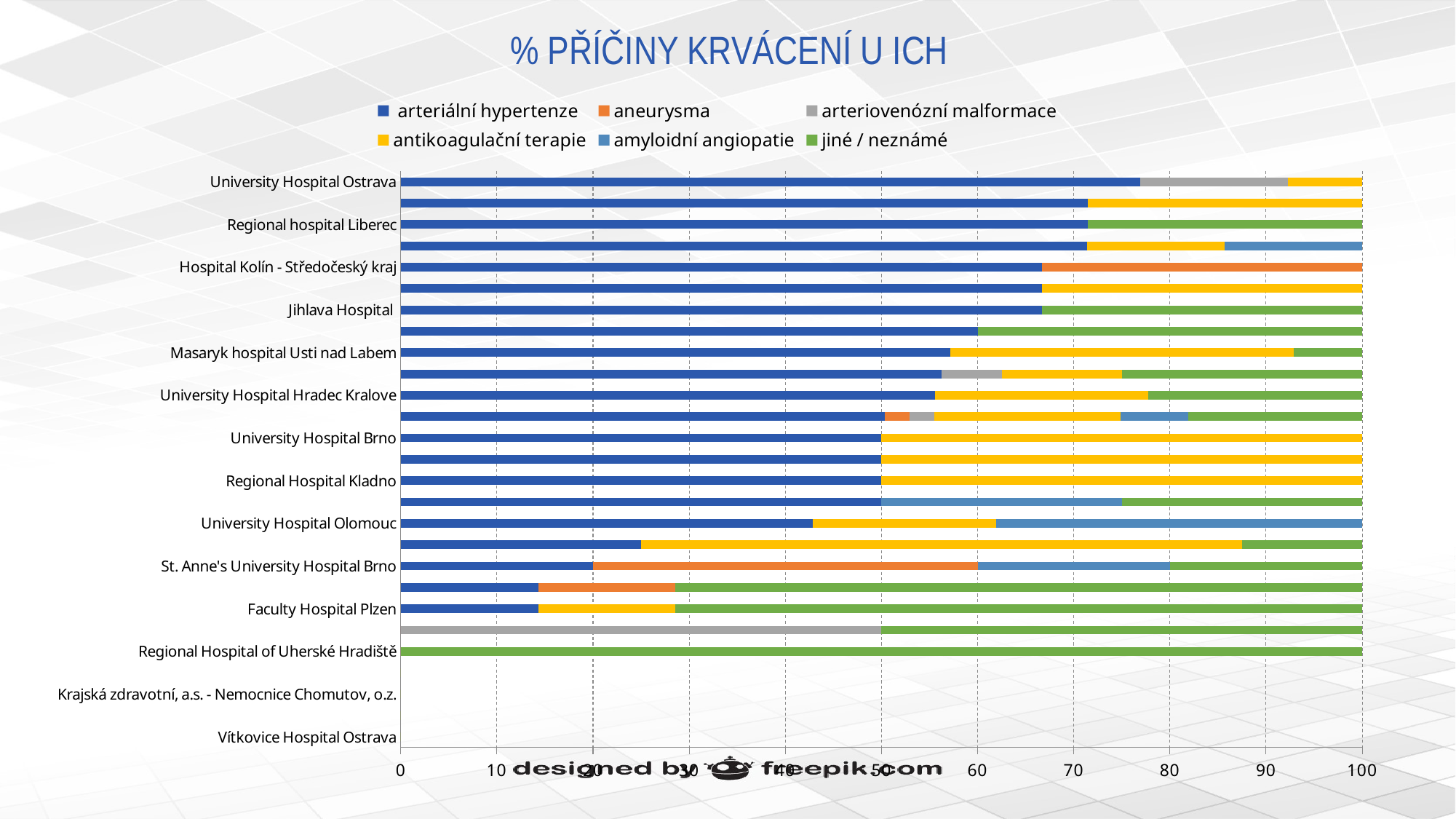
Is the value of 'arteriální hypertenze' for St. Anne's University Hospital Brno greater or less than 30? less Which colour represents 'aneurysma' in the legend? orange Is the value of 'arteriální hypertenze' for Hospital Kolín - Středočeský kraj greater or less than 70? less Is the value of 'arteriální hypertenze' for Faculty Hospital Plzen greater or less than 20? less Which has a larger value of 'amyloidní angiopatie': University Hospital Olomouc or St. Anne's University Hospital Brno? University Hospital Olomouc What is the value of 'jiné / neznámé' for Regional Hospital of Uherské Hradiště? 100 Which has a larger value of 'arteriální hypertenze': University Hospital Ostrava or Faculty Hospital Plzen? University Hospital Ostrava How many series does the legend list? 6 What is the title of the chart? % PŘÍČINY KRVÁCENÍ U ICH What kind of chart is shown on the slide? bar chart